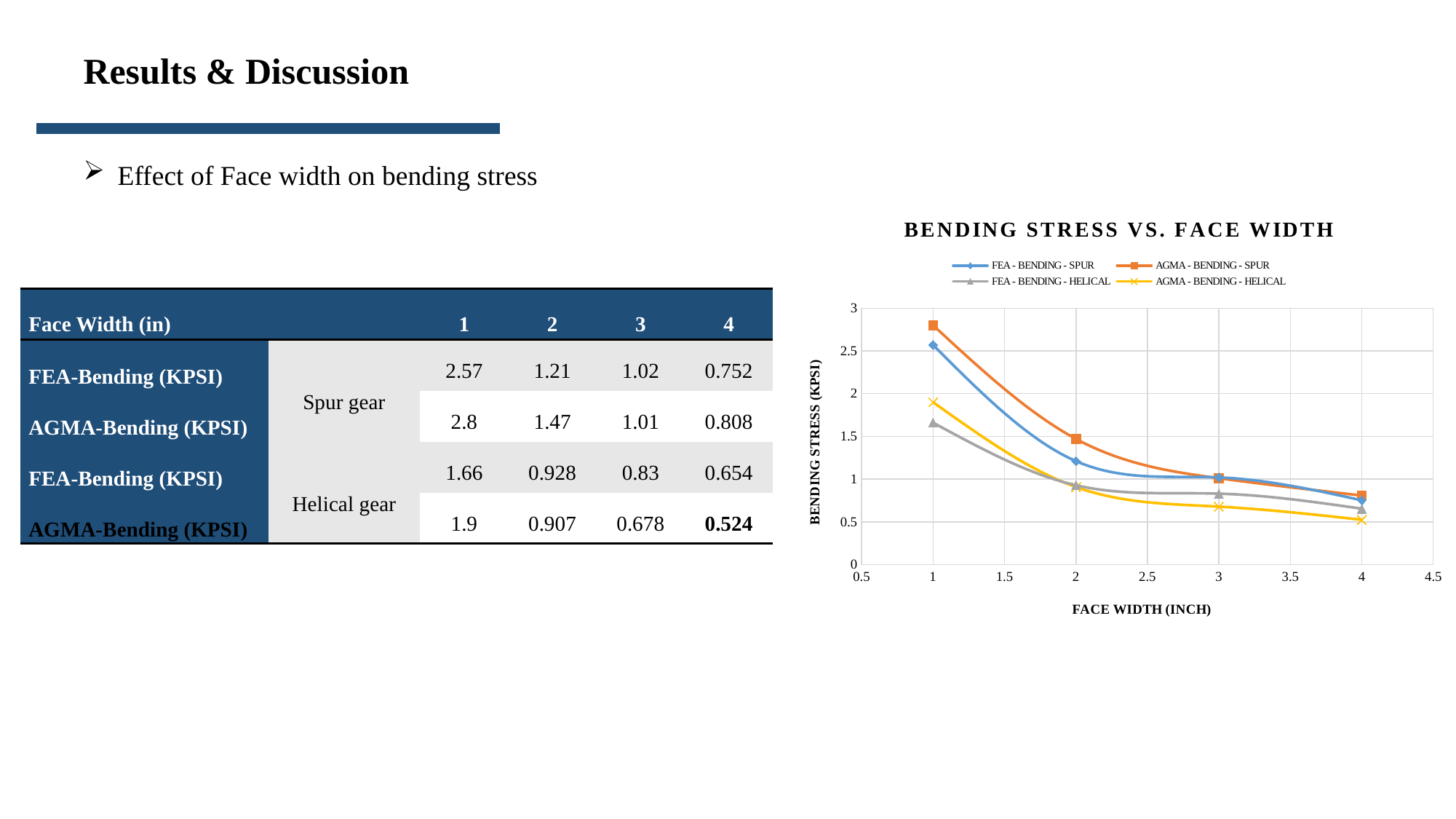
How many series does the legend of the Bending Stress vs. Face Width chart list? 4 At a face width of 2 inches, which is larger: AGMA - Bending - Spur or FEA - Bending - Spur? AGMA - Bending - Spur What is the FEA bending stress for the spur gear at a face width of 1 inch? 2.57 What is the AGMA bending stress for the helical gear at a face width of 4 inches? 0.524 What kind of chart is shown on the slide? line chart How many data points are plotted for each series in the Bending Stress vs. Face Width chart? 4 Which series has the highest bending stress at a face width of 1 inch? AGMA - Bending - Spur Which series has the lowest bending stress at a face width of 4 inches? AGMA - Bending - Helical Is the value for FEA - Bending - Helical at a face width of 1 inch greater or less than 2? less What is the title of the x axis in the Bending Stress vs. Face Width chart? FACE WIDTH (INCH) In the Bending Stress vs. Face Width chart, do the bending stress values rise or fall as face width increases? fall Is the value for AGMA - Bending - Spur at a face width of 2 inches greater or less than 1? greater